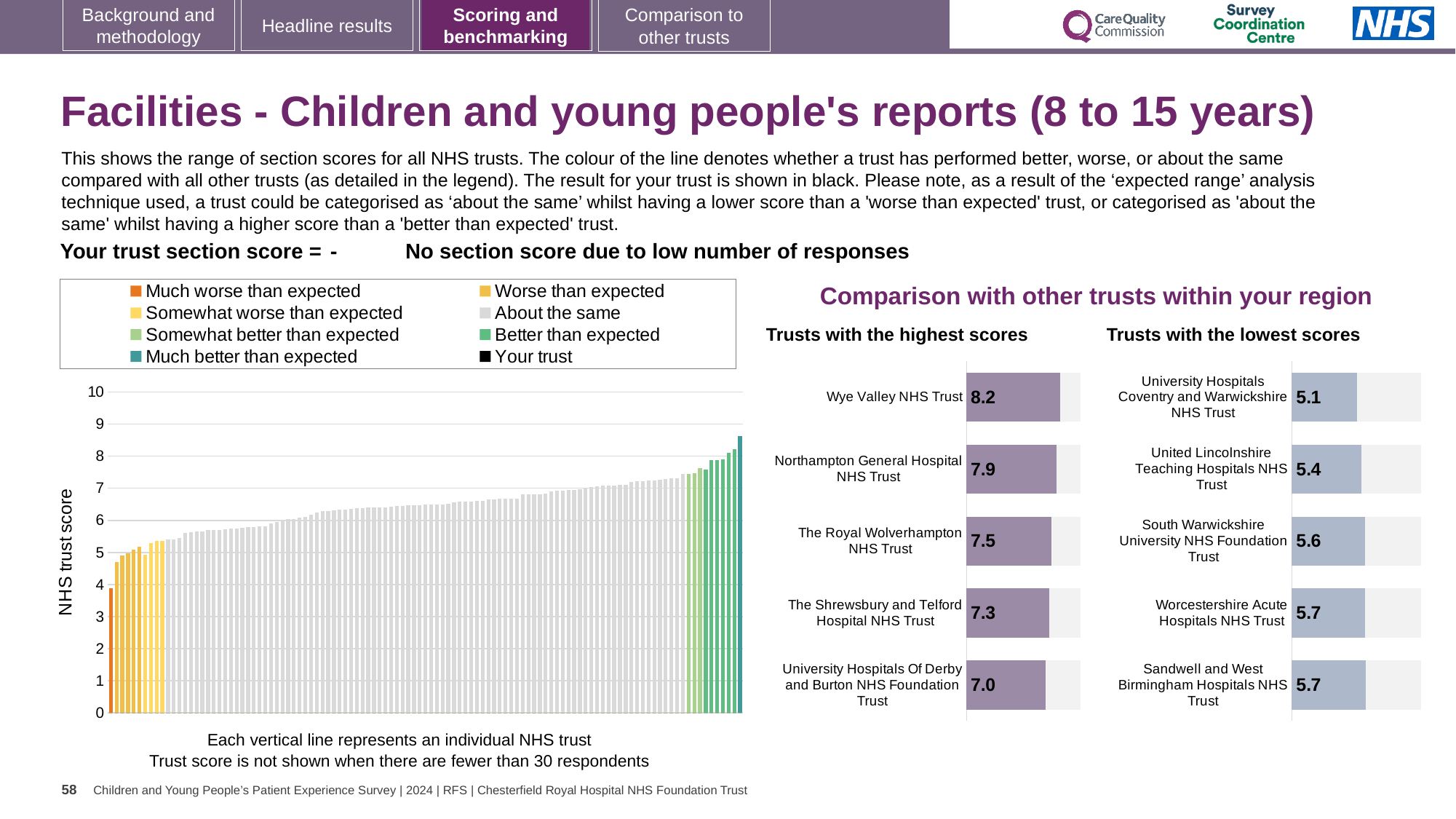
What kind of chart is the NHS trust score chart on the left of the slide? Bar chart In the NHS trust score chart on the left, is the value of the tallest bar greater or less than 8? greater How many trusts are listed in the 'Trusts with the lowest scores' chart? 5 In the 'Trusts with the lowest scores' chart, what is the score for University Hospitals Coventry and Warwickshire NHS Trust? 5.1 In the 'Trusts with the lowest scores' chart, what is the score for South Warwickshire University NHS Foundation Trust? 5.6 In the 'Trusts with the highest scores' chart, which has the higher score: Northampton General Hospital NHS Trust or The Shrewsbury and Telford Hospital NHS Trust? Northampton General Hospital NHS Trust How many entries does the legend of the NHS trust score chart on the left list? 8 In the 'Trusts with the highest scores' chart, what is the score for Wye Valley NHS Trust? 8.2 In the 'Trusts with the highest scores' chart, what is the score for The Royal Wolverhampton NHS Trust? 7.5 In the 'Trusts with the lowest scores' chart, which trust has the lowest score? University Hospitals Coventry and Warwickshire NHS Trust In the 'Trusts with the highest scores' chart, which trust has the highest score? Wye Valley NHS Trust In the 'Trusts with the highest scores' chart, what is the difference between the scores of Wye Valley NHS Trust and University Hospitals Of Derby and Burton NHS Foundation Trust? 1.2